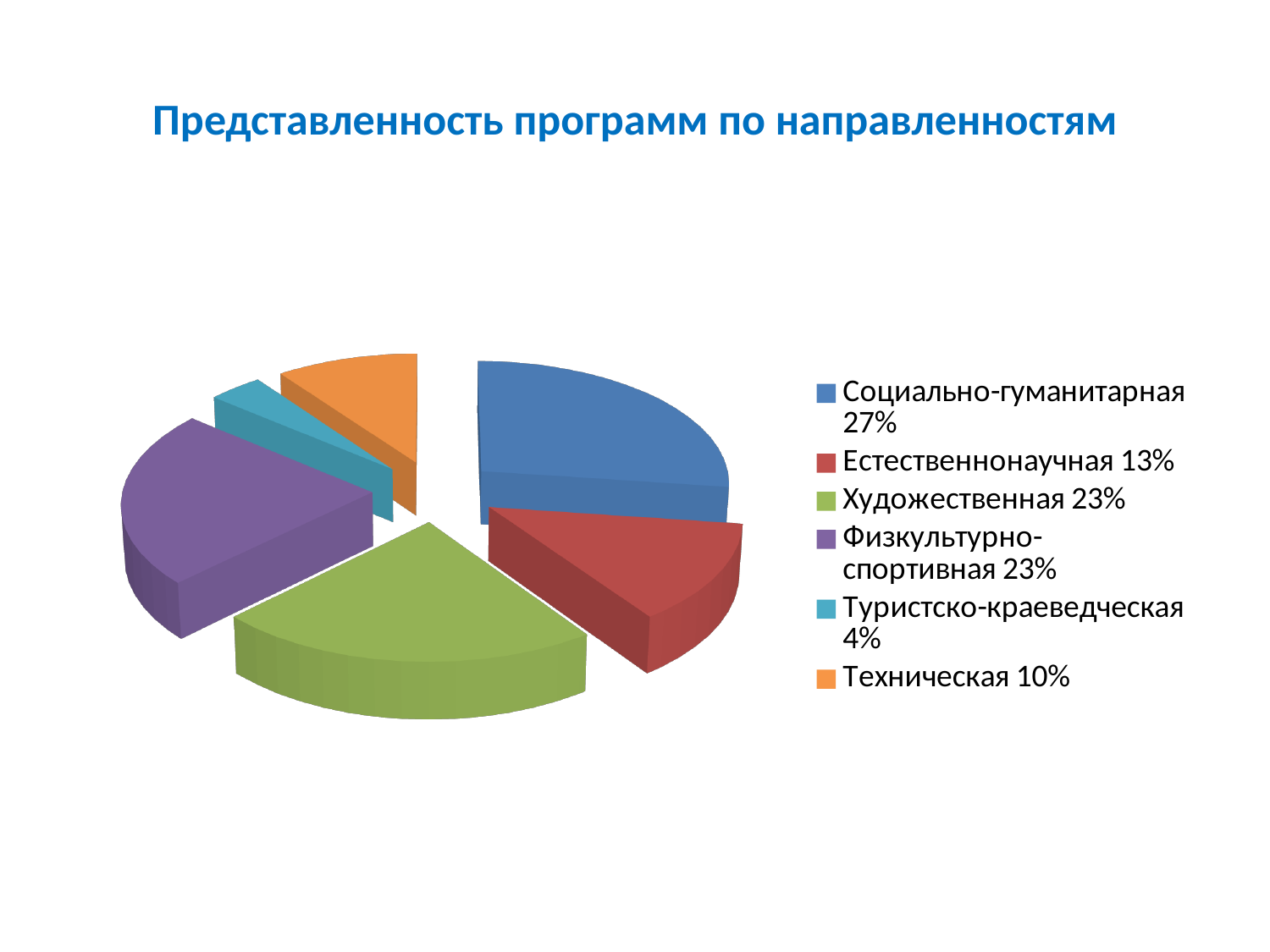
How many categories does the legend list? 6 Which is larger, the share of Техническая or the share of Естественнонаучная? Естественнонаучная What share does Техническая have? 10% What share does Туристско-краеведческая have? 4% Which category has the largest share? Социально-гуманитарная Which category has the smallest share? Туристско-краеведческая Which colour represents Художественная in the chart? Green What is the difference between the shares of Социально-гуманитарная and Естественнонаучная? 14% What is the title of the chart? Представленность программ по направленностям What share does Социально-гуманитарная have? 27% What kind of chart is shown on the slide? Pie chart